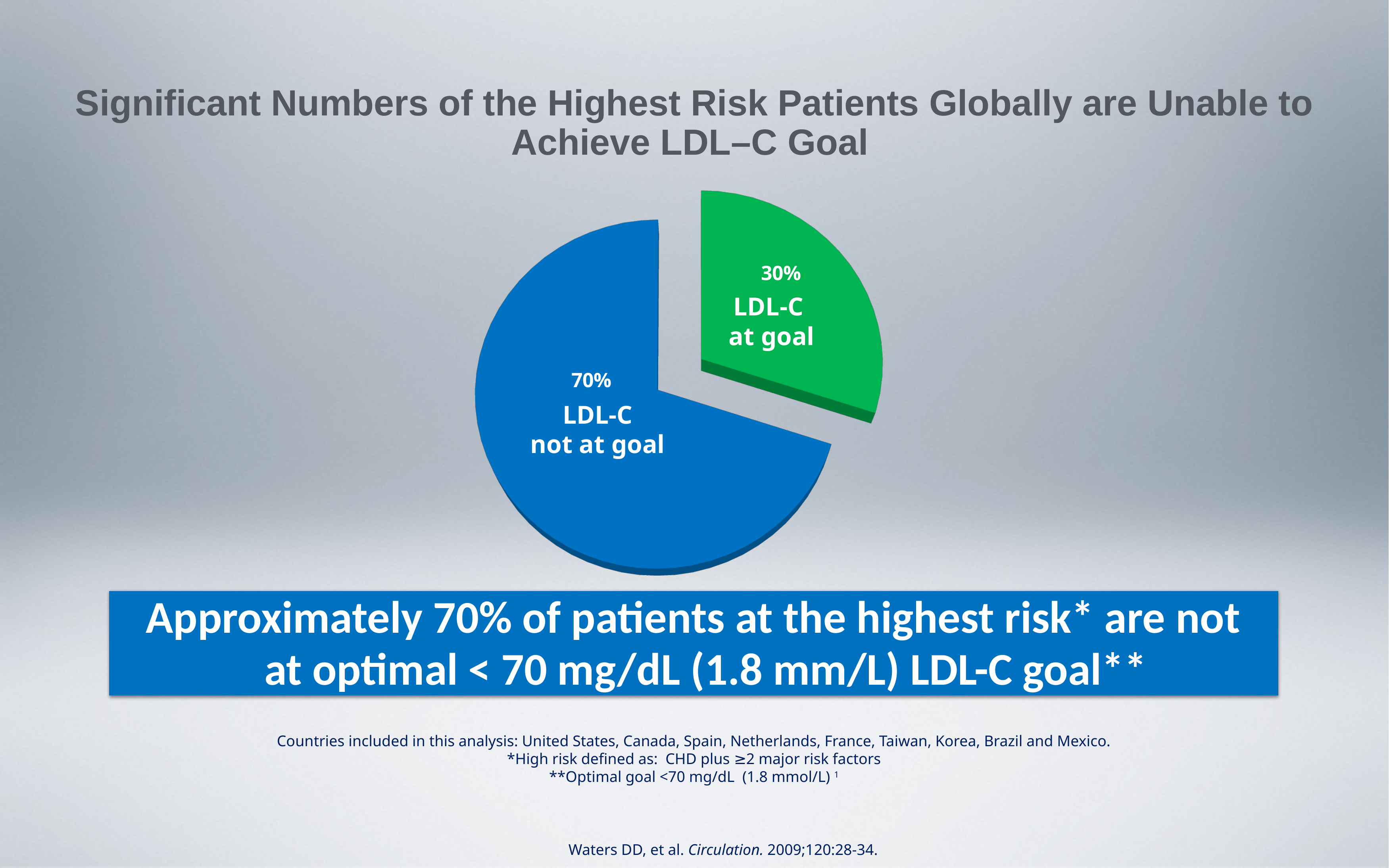
Which slice of the pie is the largest? LDL-C not at goal Which is larger: the LDL-C at goal slice or the LDL-C not at goal slice? LDL-C not at goal What colour is the LDL-C at goal slice? Green How many slices does the pie chart have? 2 What colour is the LDL-C not at goal slice? Blue Which slice of the pie is the smallest? LDL-C at goal What percentage of patients are shown as LDL-C at goal? 30% What is the difference in percentage points between the LDL-C not at goal slice and the LDL-C at goal slice? 40 What share of the pie does the LDL-C at goal slice represent? 30% What percentage of patients are shown as LDL-C not at goal? 70% What kind of chart is shown on the slide? Pie chart